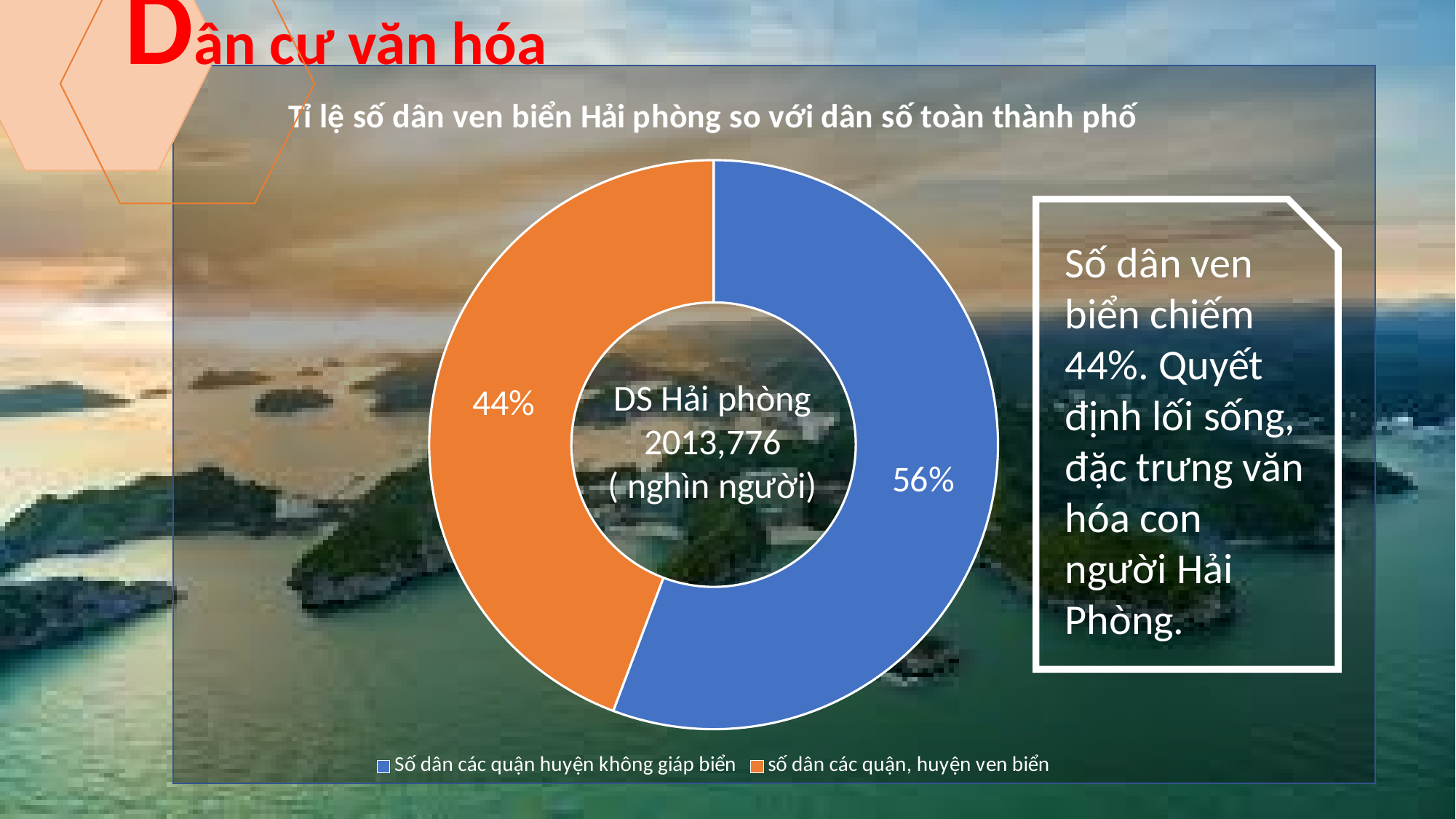
What colour is the slice for "số dân các quận, huyện ven biển"? Orange How many slices does the doughnut chart have? 2 What is the title of the chart? Tỉ lệ số dân ven biển Hải phòng so với dân số toàn thành phố What share of the doughnut chart is labelled "số dân các quận, huyện ven biển"? 44% How many entries does the chart legend list? 2 What share of the doughnut chart is labelled "Số dân các quận huyện không giáp biển"? 56% What total population figure is printed in the centre of the doughnut chart? 2013,776 ( nghìn người) What kind of chart is shown on the slide? Doughnut chart What is the difference in percentage points between the two slices of the doughnut chart? 12 Which category has the smallest share in the doughnut chart? số dân các quận, huyện ven biển Which is larger: the share for "Số dân các quận huyện không giáp biển" or the share for "số dân các quận, huyện ven biển"? Số dân các quận huyện không giáp biển Which category has the largest share in the doughnut chart? Số dân các quận huyện không giáp biển